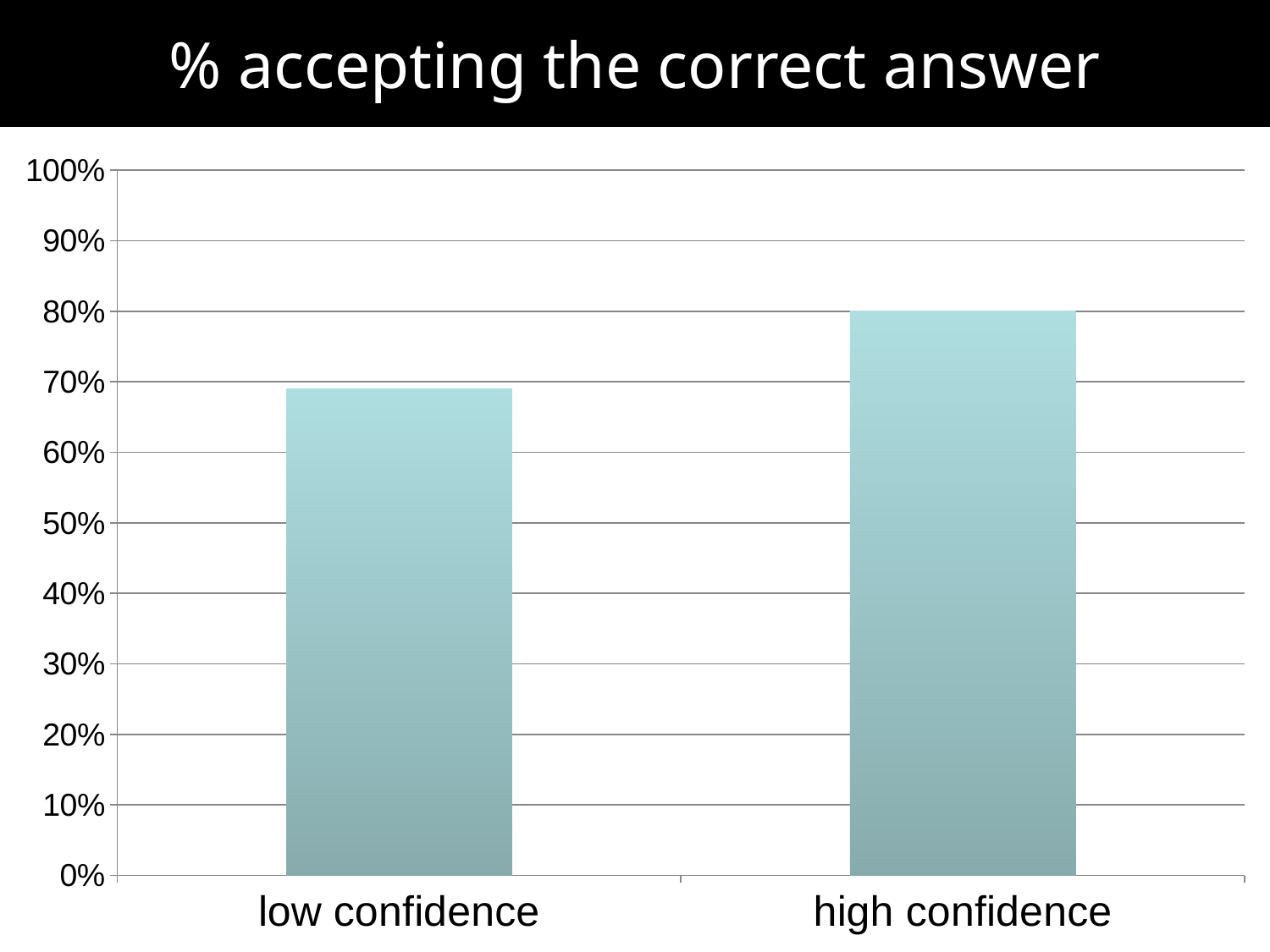
What is the value for high confidence? 80% Which is larger, the value for low confidence or the value for high confidence? high confidence Which category has the lowest value? low confidence Is the value for low confidence greater or less than 80%? less Is the value for high confidence greater or less than 90%? less Is the value for high confidence greater or less than 70%? greater What is the title of the chart? % accepting the correct answer Which category has the highest value? high confidence Do the values rise or fall from low confidence to high confidence? rise What kind of chart is shown on the slide? bar chart How many categories are shown on the x axis? 2